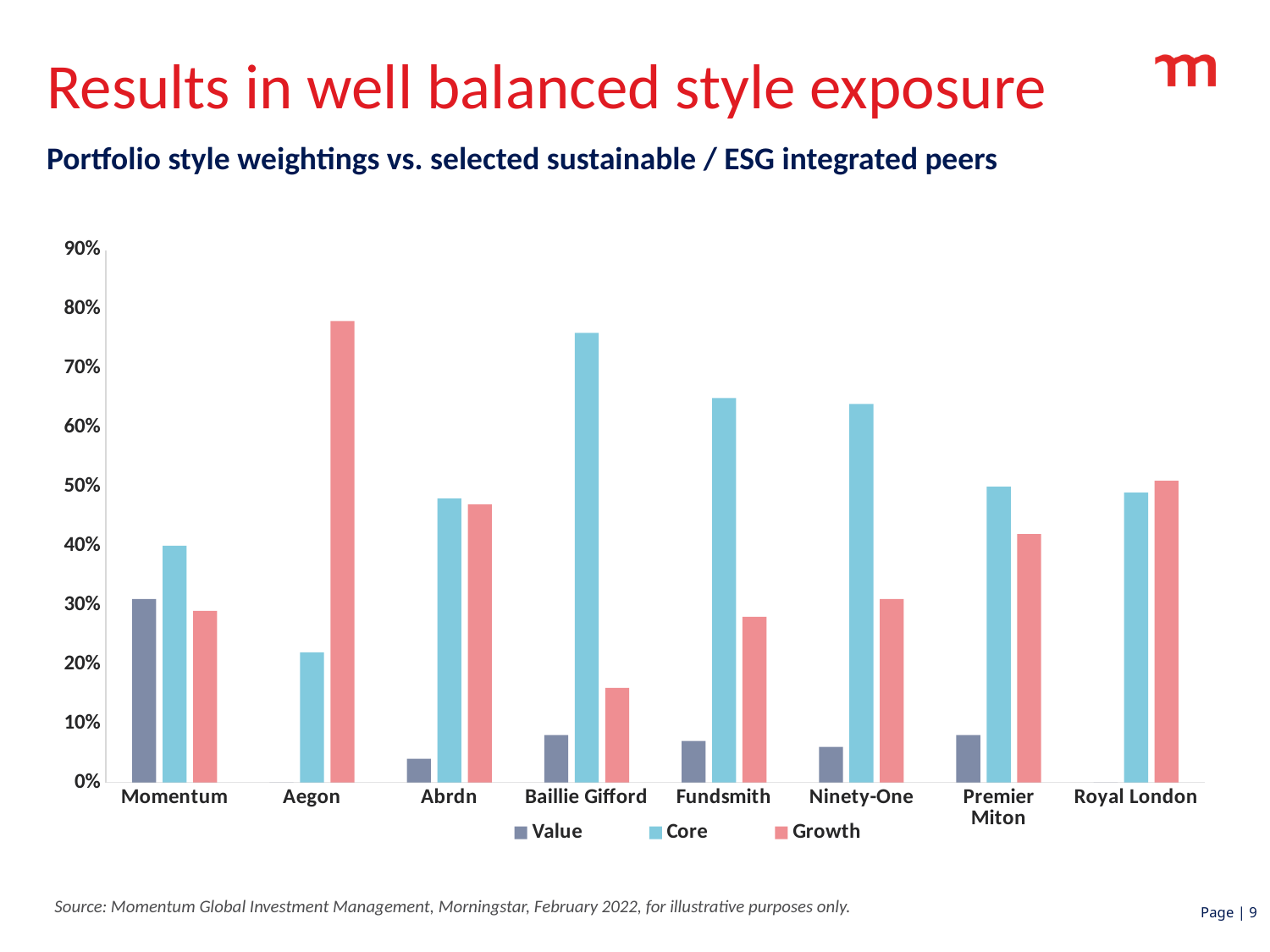
How many series does the chart's legend list? 3 How many portfolios (categories) are shown on the x axis of the chart? 8 Which portfolio has the highest Core weighting? Baillie Gifford Which portfolio has the highest Growth weighting? Aegon Which portfolio has the highest Value weighting? Momentum Is the Growth weighting for Aegon greater or less than 70%? greater What kind of chart is shown on the slide? Bar chart For Momentum, which is larger: the Core weighting or the Growth weighting? Core What are the three series named in the chart's legend? Value, Core, Growth Is the Core weighting for Aegon greater or less than 30%? less Which portfolio has the lowest Growth weighting? Baillie Gifford Is the Value weighting for Momentum greater or less than 20%? greater